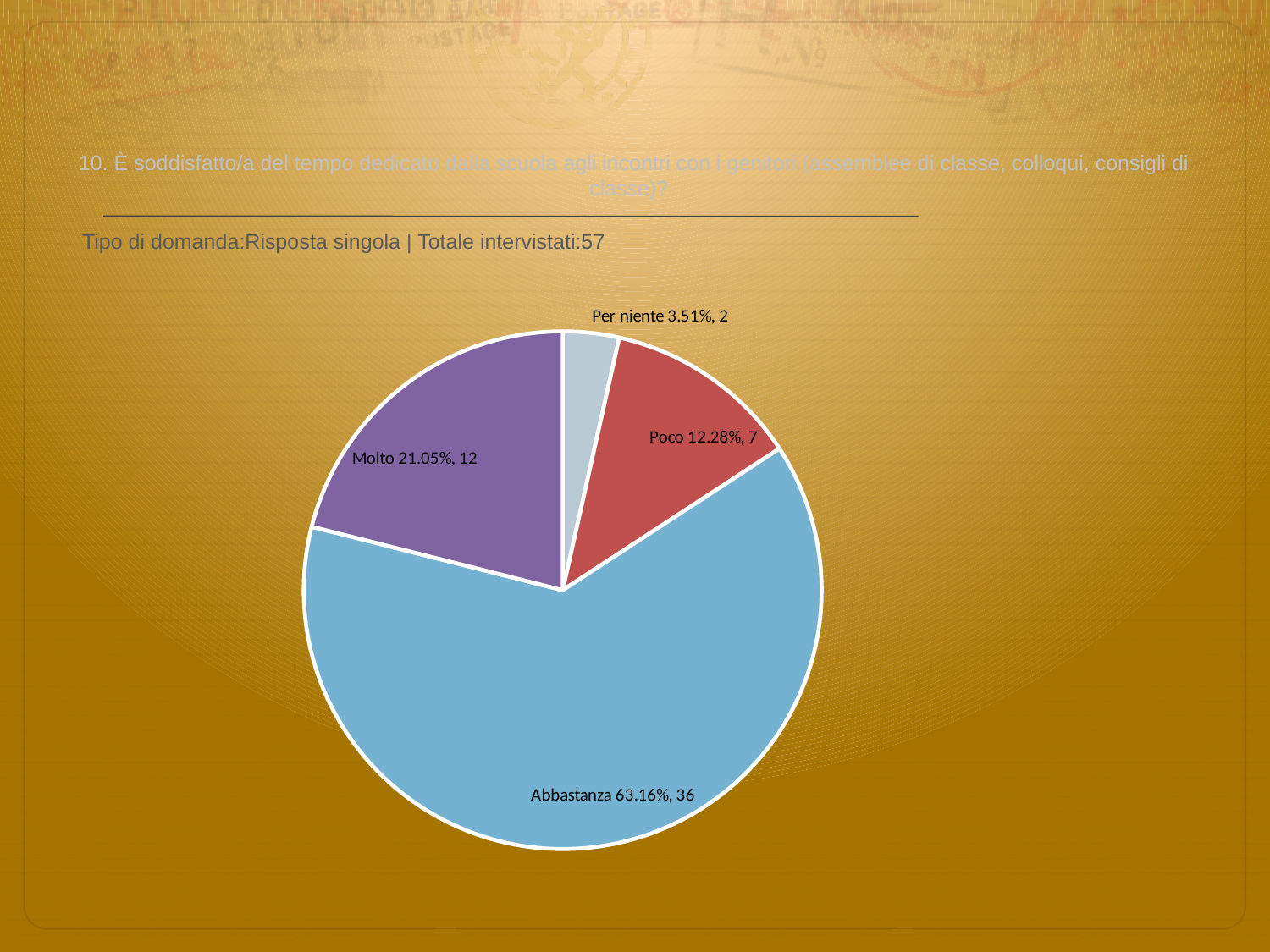
What kind of chart is shown on the slide? pie chart How many slices does the pie chart have? 4 How many respondents answered Poco? 7 What percentage share does the Per niente slice have? 3.51% How many respondents answered Molto? 12 What percentage share does the Abbastanza slice have? 63.16% Which category has the largest slice? Abbastanza What is the total number of respondents across all slices? 57 Which category has the smallest slice? Per niente What is the difference in respondent count between Abbastanza and Molto? 24 What colour is the Abbastanza slice? light blue Which has more respondents, Molto or Poco? Molto